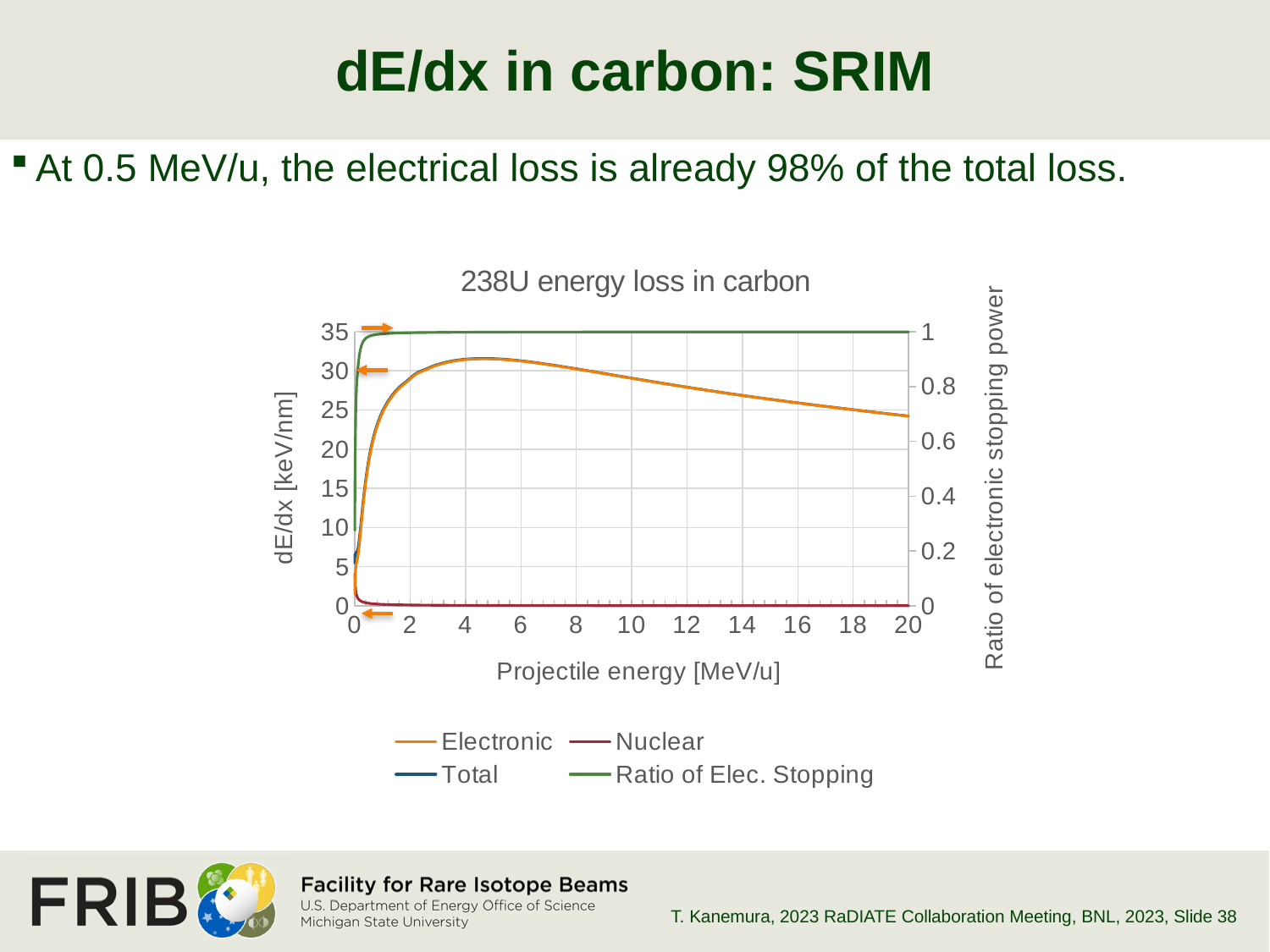
Is the Ratio of Elec. Stopping at a projectile energy of 10 MeV/u greater or less than 0.8? greater Does the Nuclear dE/dx rise or fall as projectile energy increases from 0 to 2 MeV/u? fall Which is larger at a projectile energy of 10 MeV/u, the Electronic or the Nuclear dE/dx? Electronic Is the Electronic dE/dx value at a projectile energy of 10 MeV/u greater or less than 25 keV/nm? greater Does the Electronic dE/dx rise or fall as projectile energy increases from 6 to 20 MeV/u? fall What kind of chart is shown on the slide? line chart Which series in the chart is plotted against the right-hand axis labelled 'Ratio of electronic stopping power'? Ratio of Elec. Stopping What is the title of the chart? 238U energy loss in carbon How many series does the legend of the chart list? 4 What is the label of the x axis of the chart? Projectile energy [MeV/u] Is the Electronic dE/dx value at a projectile energy of 20 MeV/u greater or less than 20 keV/nm? greater